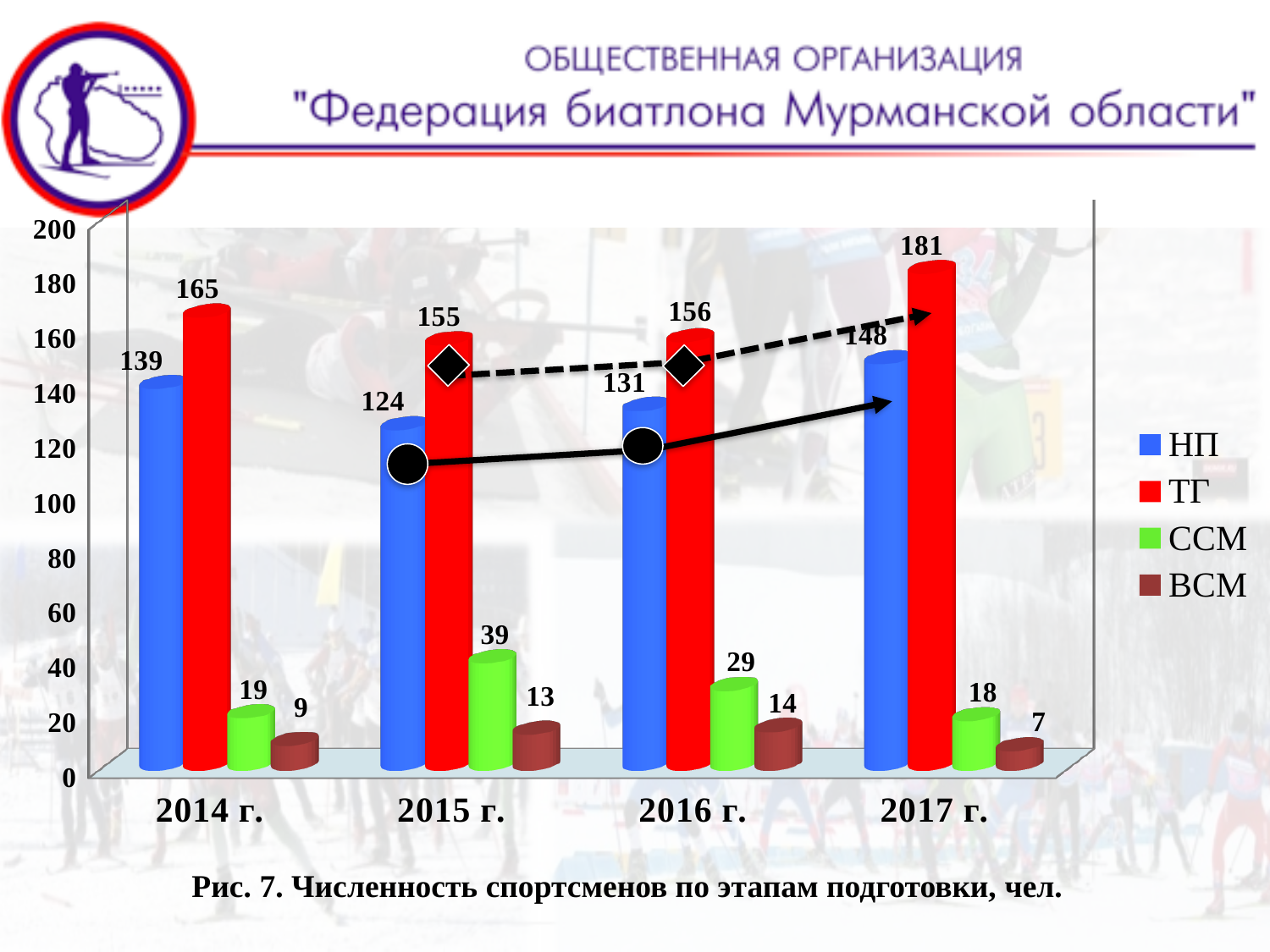
What is the value for НП in 2014 г.? 139 Does the ТГ value rise or fall from 2016 г. to 2017 г.? rise In which year is the ТГ value highest? 2017 г. What is the value for ССМ in 2015 г.? 39 What kind of chart is shown? bar chart What is the difference between the ТГ and НП values in 2016 г.? 25 What is the value for ВСМ in 2016 г.? 14 What is the value for ТГ in 2017 г.? 181 Which is larger in 2015 г., the ССМ value or the ВСМ value? ССМ How many years are shown on the x axis? 4 How many series does the legend list? 4 In which year is the ВСМ value lowest? 2017 г.